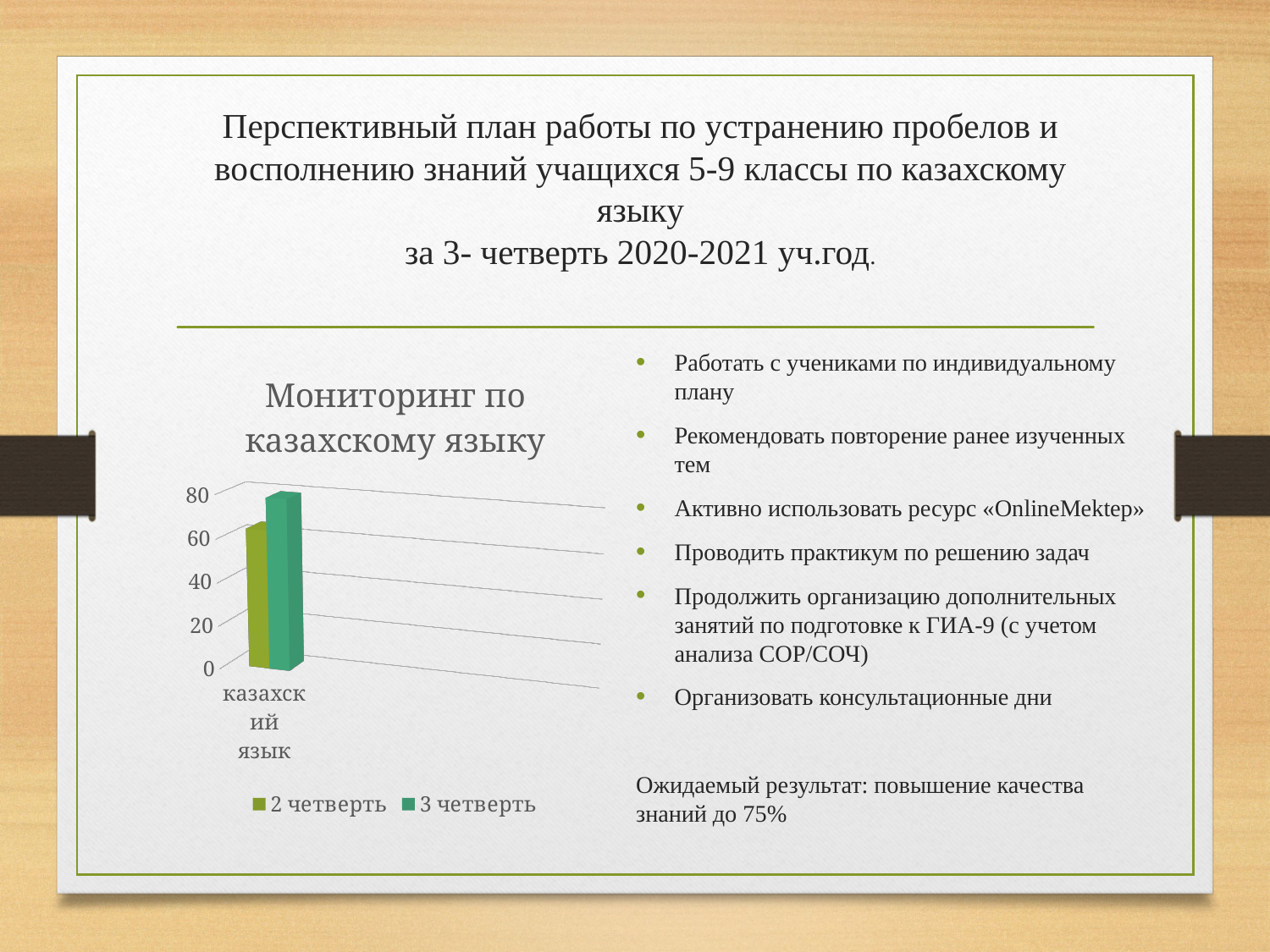
How many series does the chart legend list? 2 Which series has the lowest bar in the chart? 2 четверть Is the value for 2 четверть greater or less than 80? less What are the series names listed in the chart legend? 2 четверть, 3 четверть What kind of chart is shown on the slide? bar chart Is the value for 2 четверть greater or less than 40? greater What is the title of the chart? Мониторинг по казахскому языку How many categories are shown on the x axis of the chart? 1 Which series has the higher value for казахский язык: 2 четверть or 3 четверть? 3 четверть Which series has the highest bar in the chart? 3 четверть Is the value for 3 четверть greater or less than 60? greater